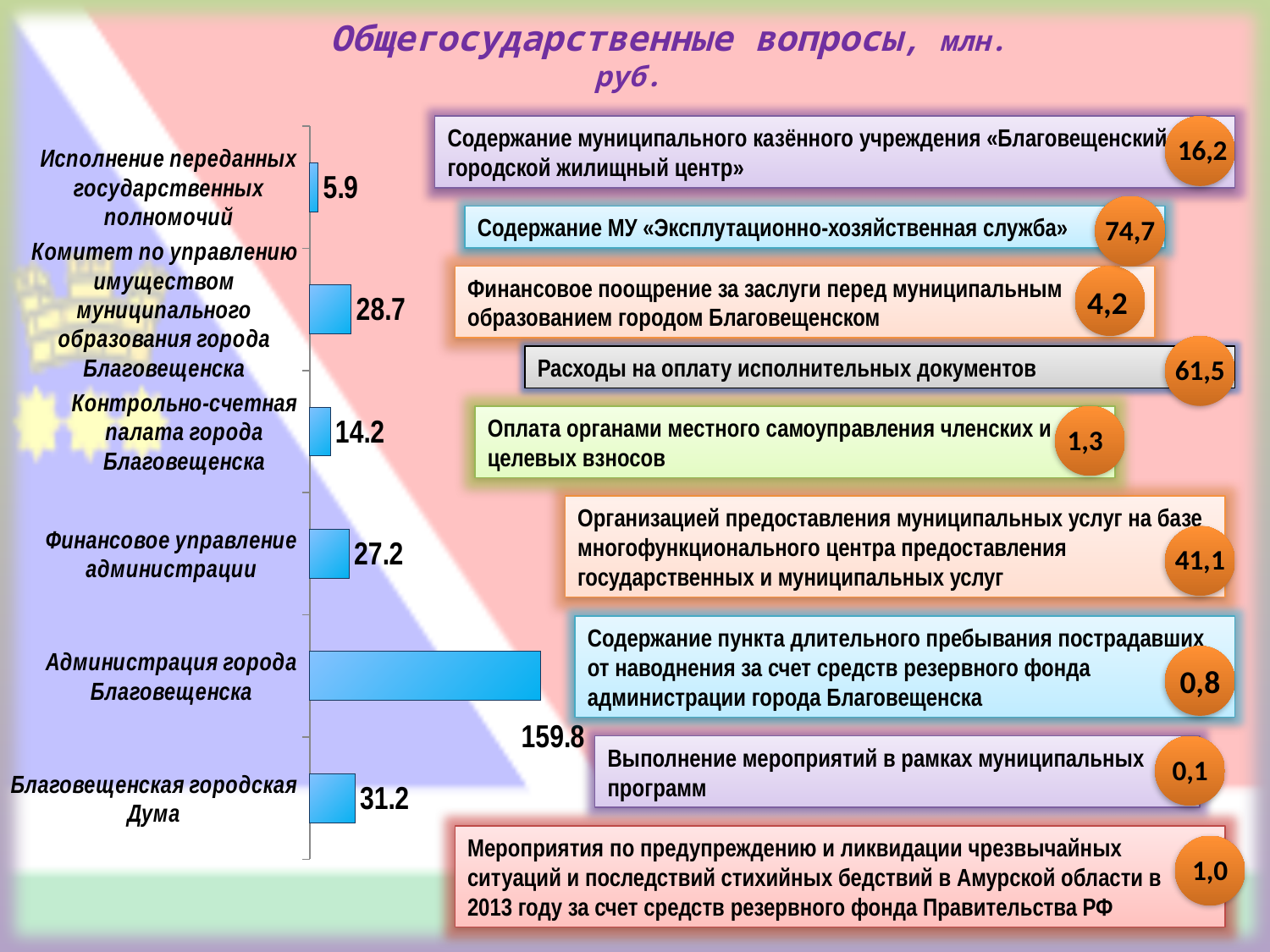
What is the title of the chart? Общегосударственные вопросы, млн. руб. What kind of chart is shown on the slide? bar chart What is the value for Исполнение переданных государственных полномочий? 5.9 Which is larger: the value for Комитет по управлению имуществом муниципального образования города Благовещенска or the value for Контрольно-счетная палата города Благовещенска? Комитет по управлению имуществом муниципального образования города Благовещенска What is the value for Администрация города Благовещенска? 159.8 How many categories are shown in the bar chart? 6 What is the value for Благовещенская городская Дума? 31.2 What is the value for Контрольно-счетная палата города Благовещенска? 14.2 What is the difference between the values for Благовещенская городская Дума and Финансовое управление администрации? 4.0 Which category has the highest value? Администрация города Благовещенска What is the value for Финансовое управление администрации? 27.2 Which category has the lowest value? Исполнение переданных государственных полномочий